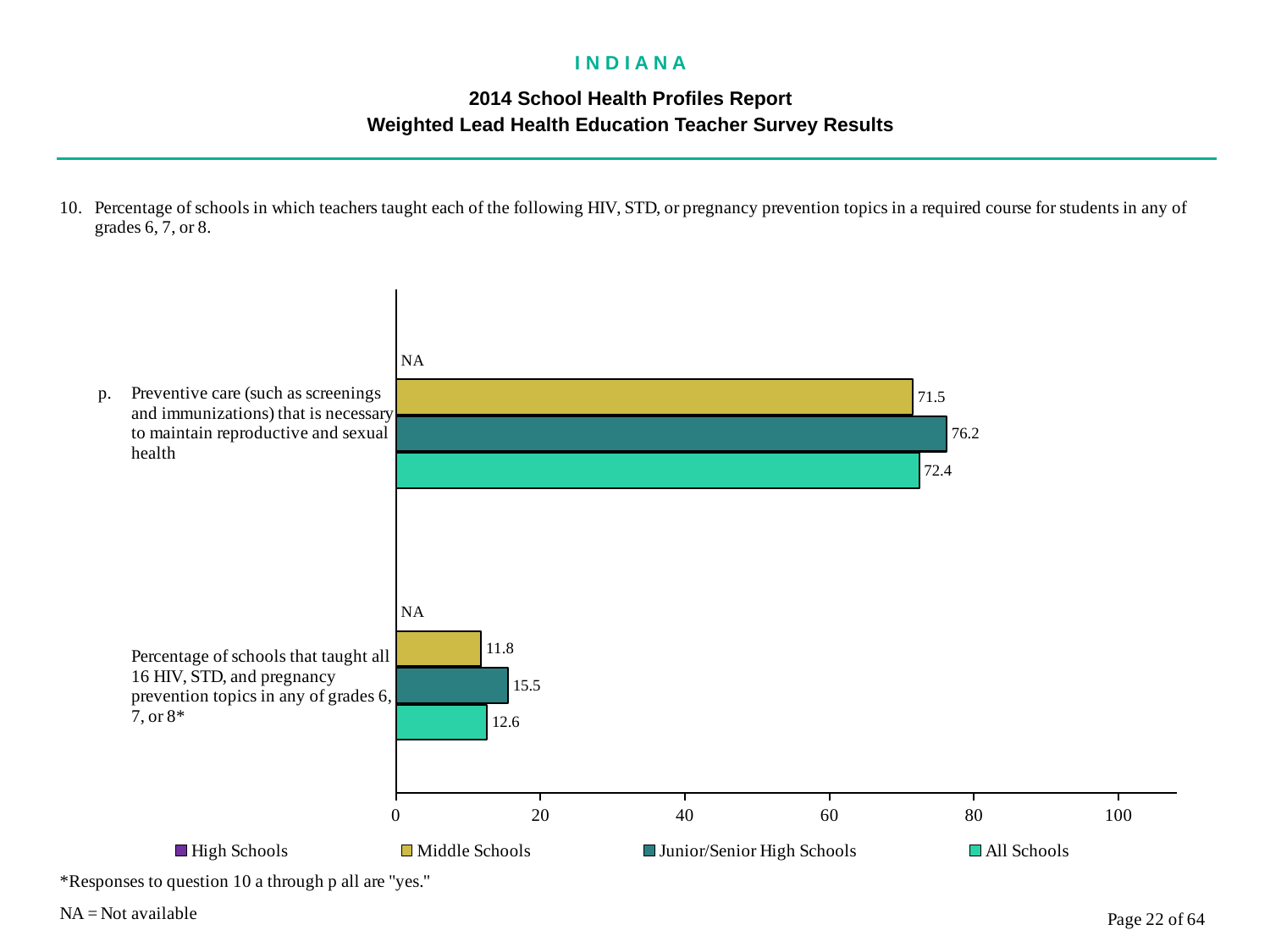
What is shown for High Schools in both categories? NA Which is larger for the 'Percentage of schools that taught all 16 HIV, STD, and pregnancy prevention topics' category: All Schools or Middle Schools? All Schools Is the All Schools value for the 'Preventive care' category greater or less than 60? greater What kind of chart is shown on the slide? bar chart What is the maximum value shown on the horizontal axis? 100 What is the value for Middle Schools for the 'Preventive care (such as screenings and immunizations) that is necessary to maintain reproductive and sexual health' category? 71.5 Which series has the lowest value for the 'Percentage of schools that taught all 16 HIV, STD, and pregnancy prevention topics' category? Middle Schools What is the value for All Schools for the 'Preventive care' category? 72.4 Which series has the highest value for the 'Preventive care' category? Junior/Senior High Schools What is the value for Junior/Senior High Schools for the 'Percentage of schools that taught all 16 HIV, STD, and pregnancy prevention topics in any of grades 6, 7, or 8' category? 15.5 What is the difference between the Junior/Senior High Schools and Middle Schools values for the 'Preventive care' category? 4.7 How many series does the legend list? 4